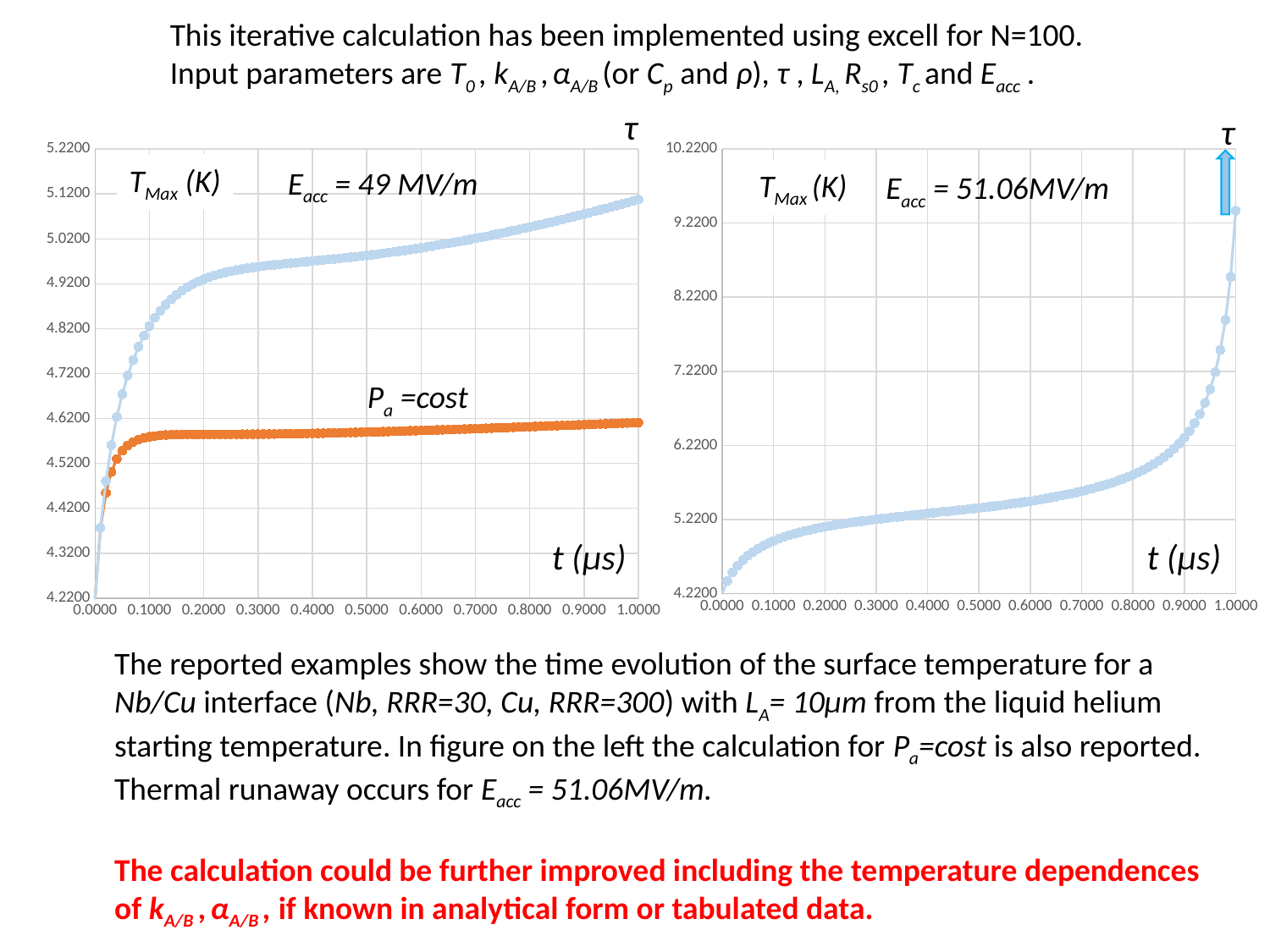
What kind of chart is the left chart (E_acc = 49 MV/m)? line chart In the left chart (E_acc = 49 MV/m), is the orange P_a = cost series value at t = 1.0000 greater or less than 4.5200? greater In the left chart (E_acc = 49 MV/m), how many data series are plotted? 2 In the right chart (E_acc = 51.06 MV/m), how many data series are plotted? 1 In the right chart (E_acc = 51.06 MV/m), does T_Max rise or fall as t increases? rise In the left chart (E_acc = 49 MV/m), is the blue series value at t = 1.0000 greater or less than 5.0200? greater In the right chart (E_acc = 51.06 MV/m), is the value at t = 0.5000 greater or less than 6.2200? less In the left chart (E_acc = 49 MV/m), at t = 0.5000, which series has the larger value: the blue series or the orange P_a = cost series? the blue series What is the highest tick value on the vertical axis of the right chart (E_acc = 51.06 MV/m)? 10.2200 What is the label of the horizontal axis in the left chart (E_acc = 49 MV/m)? t (µs) In the left chart (E_acc = 49 MV/m), does the blue T_Max series rise or fall as t increases? rise